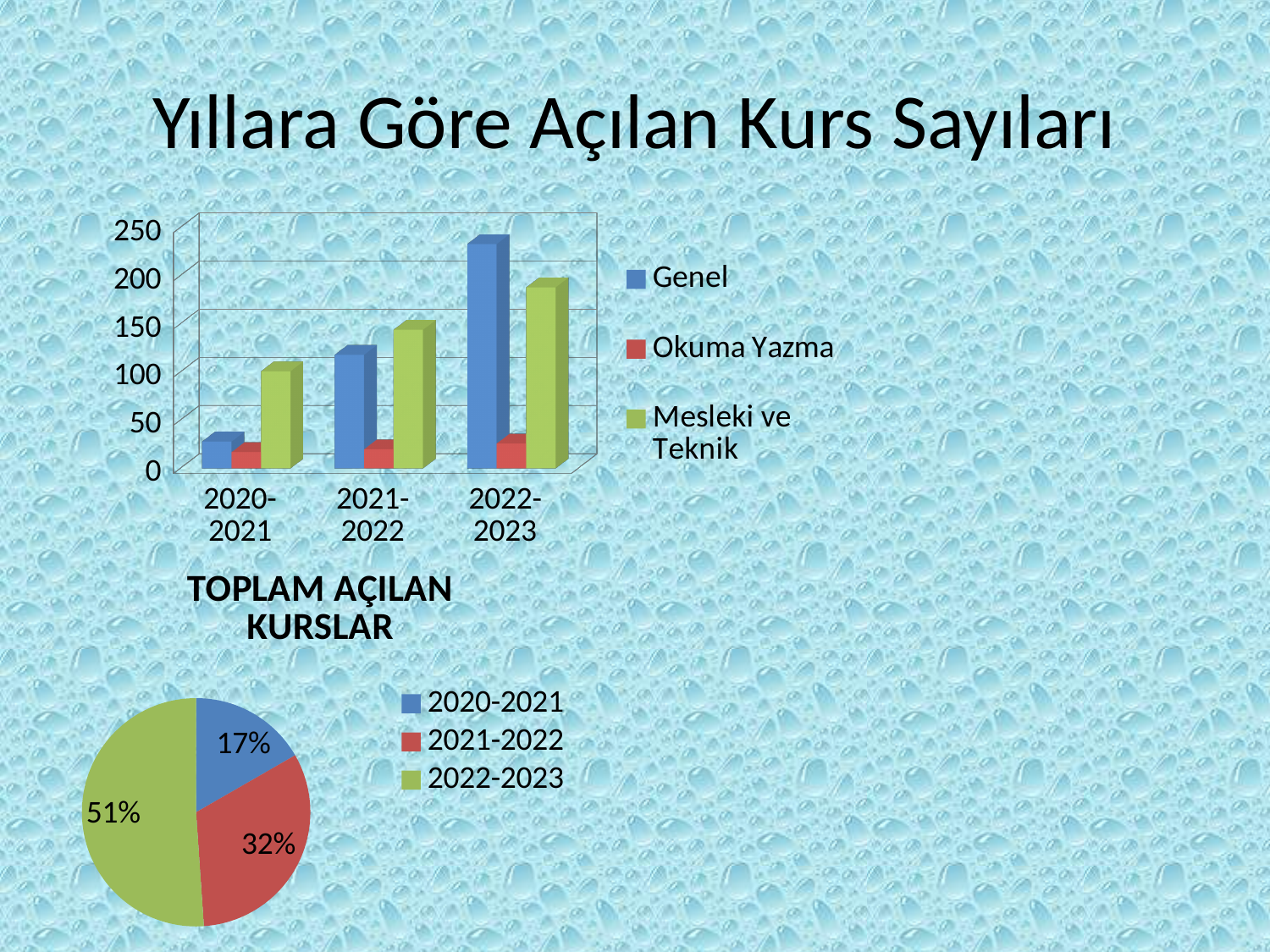
In the pie chart titled TOPLAM AÇILAN KURSLAR, how many percentage points larger is the 2022-2023 slice than the 2020-2021 slice? 34 In the pie chart titled TOPLAM AÇILAN KURSLAR, what share does 2020-2021 have? 17% In the top chart, how many year categories are shown on the x axis? 3 In the pie chart titled TOPLAM AÇILAN KURSLAR, what share does 2022-2023 have? 51% In the pie chart titled TOPLAM AÇILAN KURSLAR, what share does 2021-2022 have? 32% In the top chart, is the value for Okuma Yazma in 2022-2023 greater or less than 50? less In the pie chart titled TOPLAM AÇILAN KURSLAR, which year has the largest slice? 2022-2023 In the top chart, is the value for Genel in 2022-2023 greater or less than 200? greater In the pie chart titled TOPLAM AÇILAN KURSLAR, which year has the smallest slice? 2020-2021 What kind of chart is the top chart on the slide? bar chart In the top chart, do the Genel values rise or fall from 2020-2021 to 2022-2023? rise In the top chart, how many series does the legend list? 3